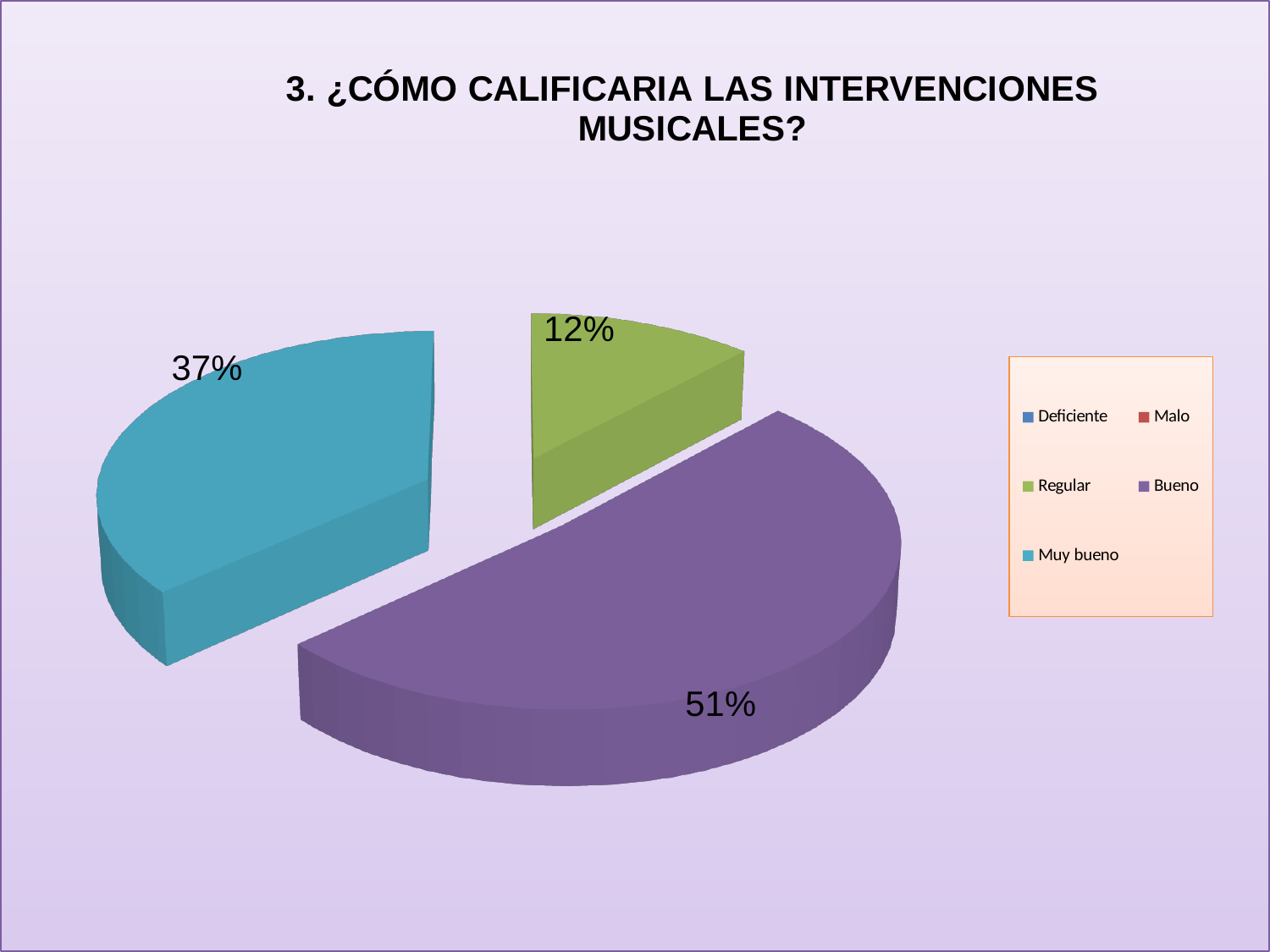
What percentage of the pie is labelled for Bueno? 51% What is the difference in percentage points between Muy bueno and Regular? 25 What percentage of the pie is labelled for Regular? 12% Which is larger, the slice for Muy bueno or the slice for Regular? Muy bueno How many categories does the legend list? 5 Which category has the largest slice of the pie? Bueno What is the difference in percentage points between Bueno and Muy bueno? 14 What kind of chart is shown on the slide? pie chart Which of the visible slices is the smallest? Regular What percentage of the pie is labelled for Muy bueno? 37% What colour is the slice for Muy bueno? teal/blue What is the title of the chart? 3. ¿CÓMO CALIFICARIA LAS INTERVENCIONES MUSICALES?